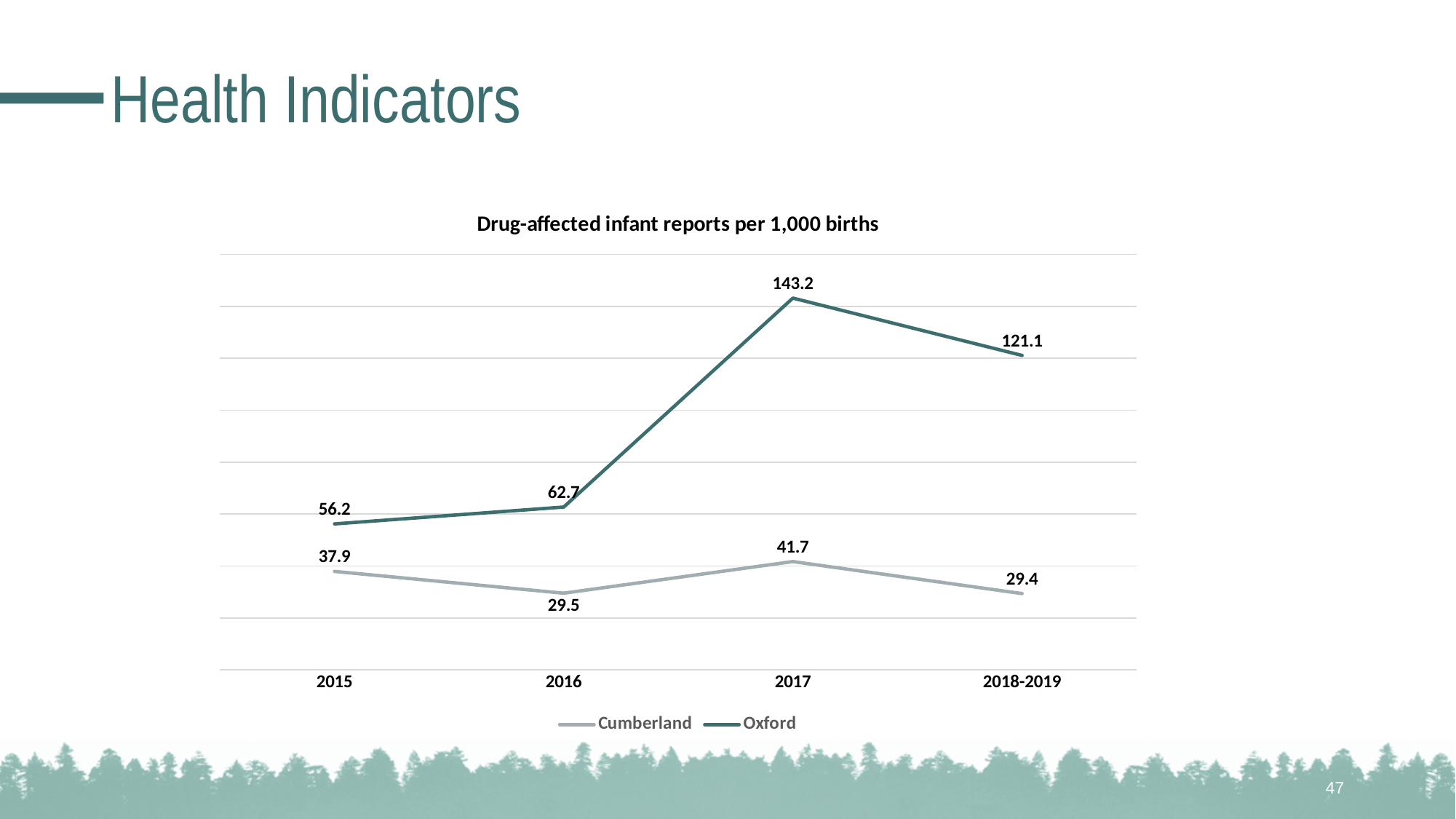
Which series has the larger value in 2015, Cumberland or Oxford? Oxford What is the value for Cumberland in 2016? 29.5 How many series does the legend list? 2 What kind of chart is shown on the slide? Line chart In which year does the Oxford series reach its highest value? 2017 What is the title of the chart? Drug-affected infant reports per 1,000 births Does the Oxford series rise or fall from 2017 to 2018-2019? Fall What is the value for Oxford in 2018-2019? 121.1 How many time periods are shown on the x axis? 4 In which period does the Cumberland series have its lowest value? 2018-2019 What is the value for Oxford in 2017? 143.2 What is the difference between the Oxford and Cumberland values in 2017? 101.5